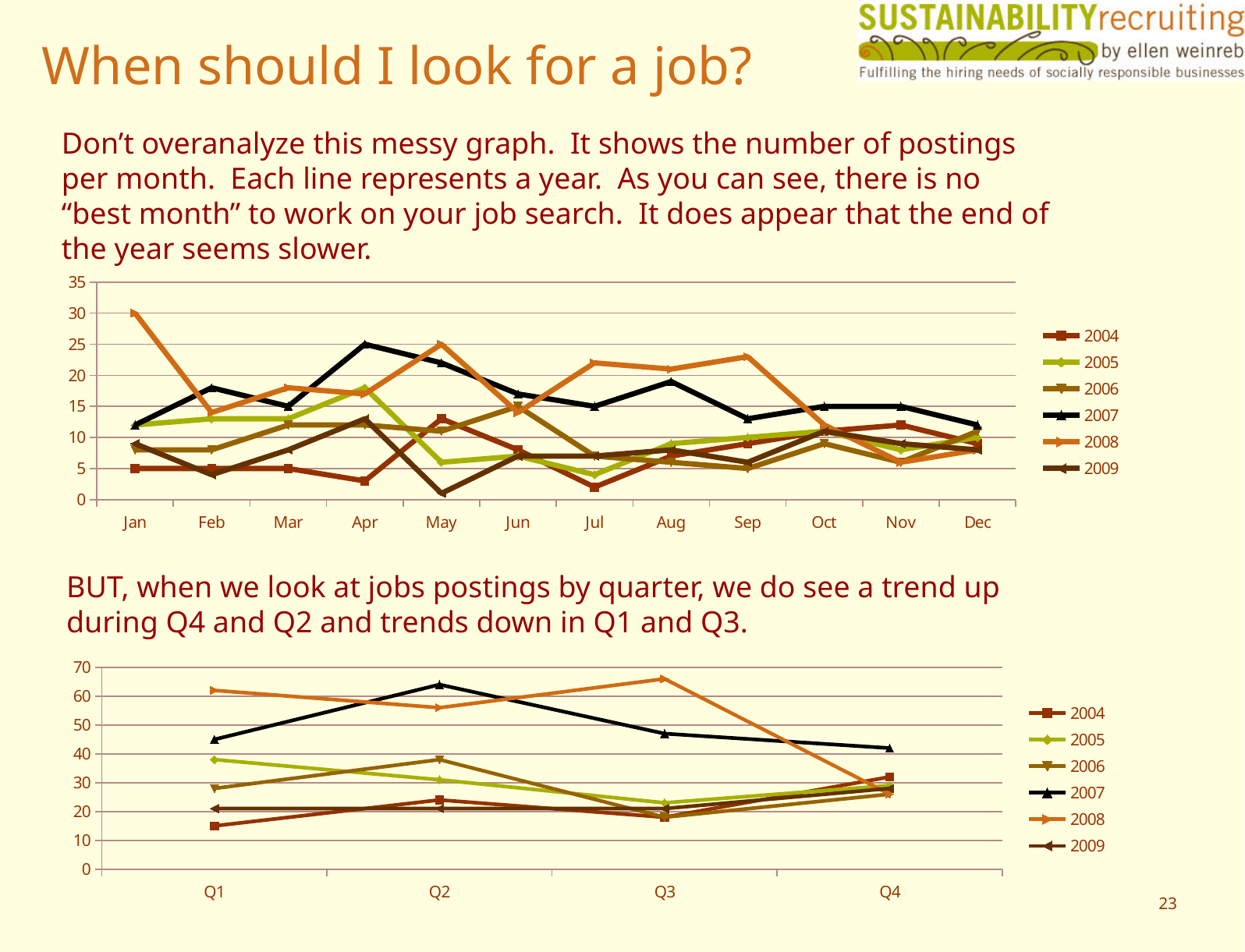
In the top chart (postings per month), how many months are shown on the x axis? 12 In the bottom chart (postings by quarter), how many quarters are shown on the x axis? 4 In the top chart (postings per month), which year has the highest value in Jan? 2008 In the top chart (postings per month), is the value for 2004 in Jan greater or less than 10? less In the bottom chart (postings by quarter), is the value for 2007 in Q2 greater or less than 60? greater What kind of chart is the top chart showing postings per month? line chart In the top chart (postings per month), how many series does the legend list? 6 In the bottom chart (postings by quarter), does the 2007 line rise or fall from Q2 to Q4? fall In the top chart (postings per month), is the value for 2007 in Apr greater or less than 20? greater In the bottom chart (postings by quarter), which year has the lowest value in Q1? 2004 In the bottom chart (postings by quarter), which year has the highest value in Q3? 2008 In the top chart (postings per month), what is the value for 2008 in Jan? 30